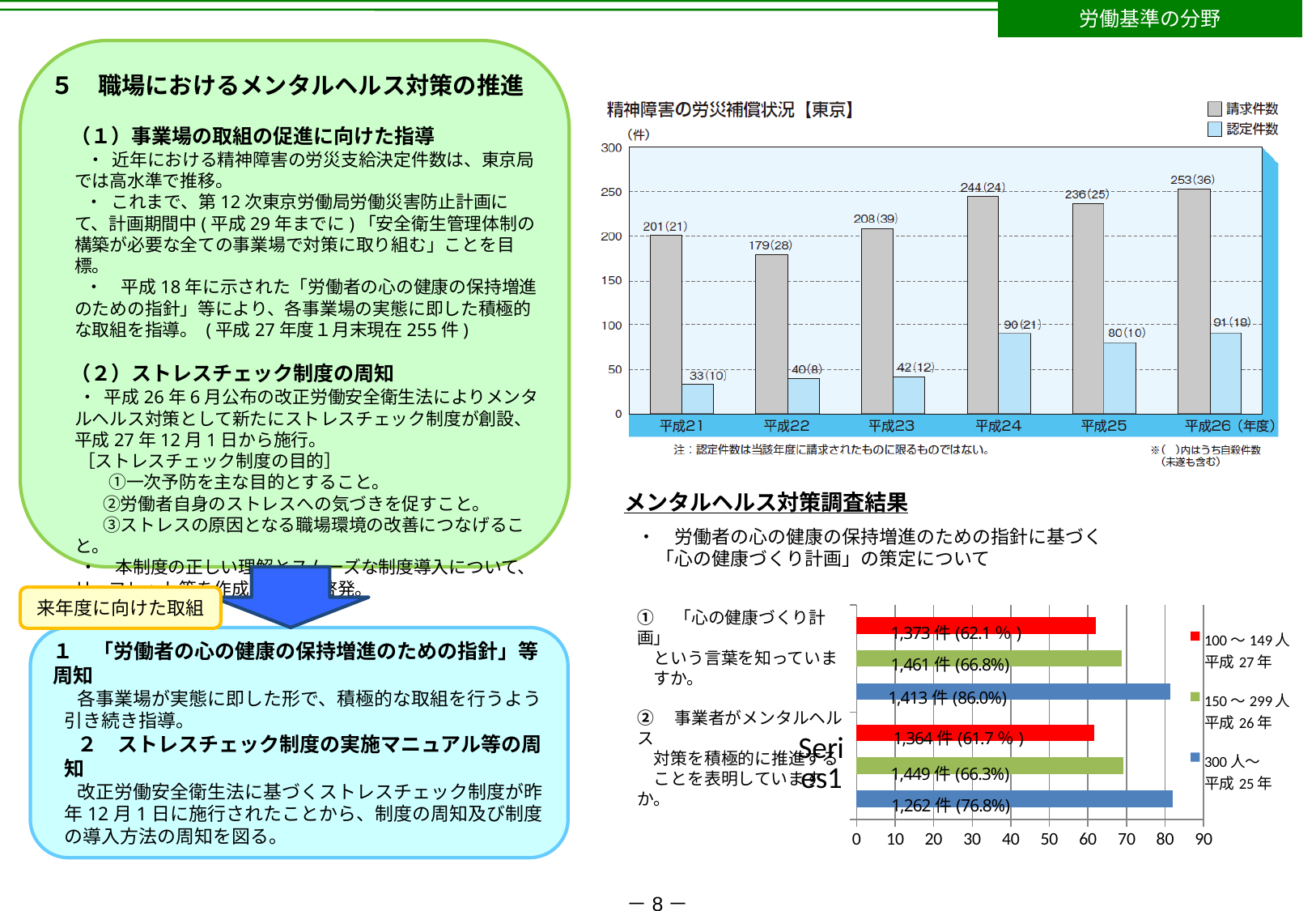
In the top chart titled 精神障害の労災補償状況【東京】, how many series does the legend list? 2 In the top chart titled 精神障害の労災補償状況【東京】, what is the difference in 請求件数 between 平成26 (253) and 平成21 (201)? 52 What kind of chart is the bottom chart under メンタルヘルス対策調査結果? bar chart In the top chart titled 精神障害の労災補償状況【東京】, which year has the lowest 認定件数? 平成21 In the top chart titled 精神障害の労災補償状況【東京】, how many years are shown on the x axis? 6 In the bottom chart under メンタルヘルス対策調査結果, how many series does the legend list? 3 What kind of chart is the top chart titled 精神障害の労災補償状況【東京】? bar chart In the top chart titled 精神障害の労災補償状況【東京】, is the 請求件数 for 平成22 larger or smaller than that for 平成23? smaller In the top chart titled 精神障害の労災補償状況【東京】, what is the 認定件数 value labelled for 平成24? 90(21) In the top chart titled 精神障害の労災補償状況【東京】, what is the 請求件数 value labelled for 平成26? 253(36) In the top chart titled 精神障害の労災補償状況【東京】, which year has the highest 請求件数? 平成26 In the bottom chart under メンタルヘルス対策調査結果, what is the value labelled on the 300人〜 平成25年 bar for question ①? 1,413件(86.0%)